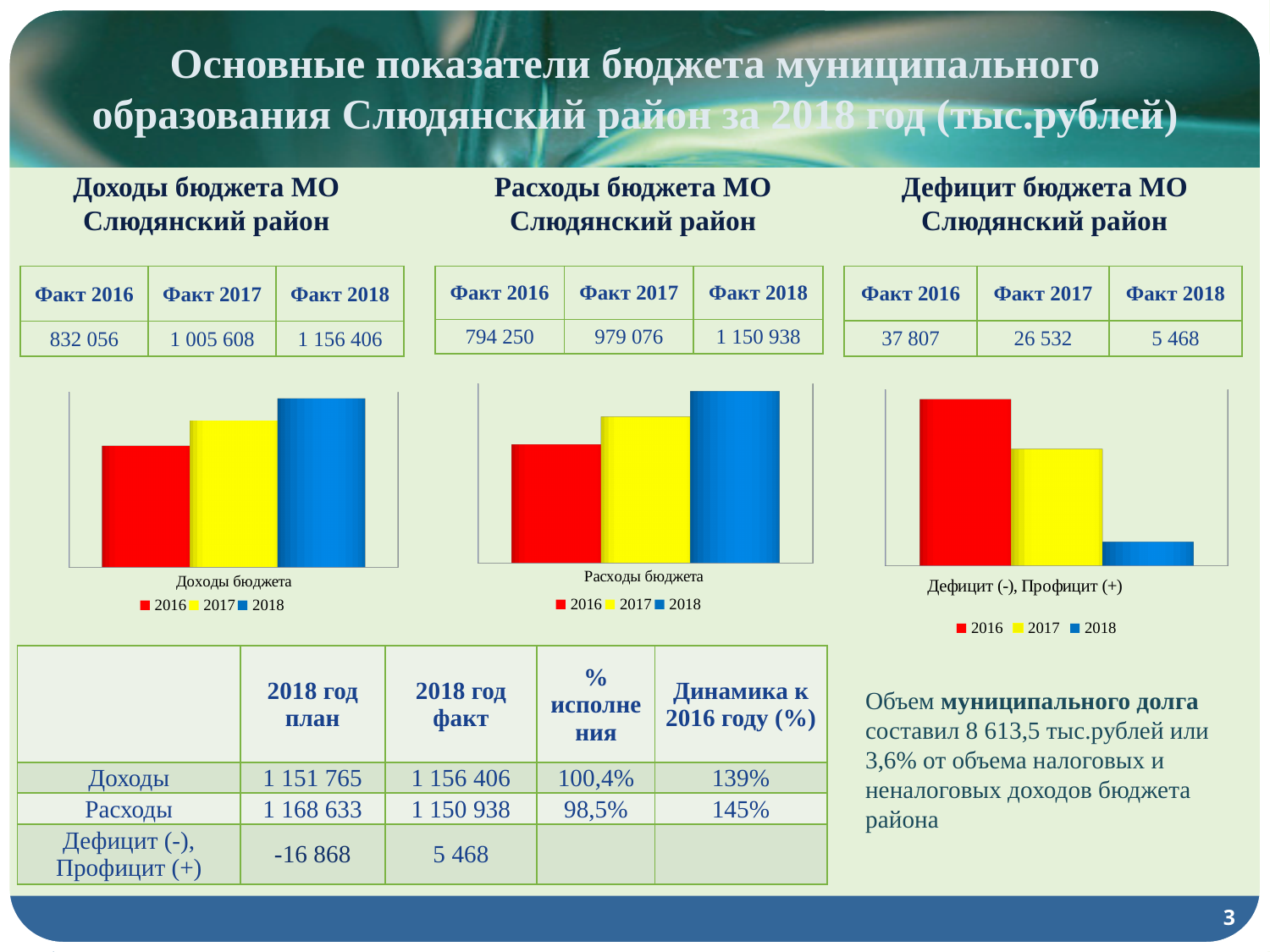
On the left chart (Доходы бюджета МО Слюдянский район), do the bars rise or fall from 2016 to 2018? rise On the left chart (Доходы бюджета МО Слюдянский район), what is the value for 2017 according to the table above the chart? 1 005 608 On the middle chart (Расходы бюджета МО Слюдянский район), what is the difference between the 2018 and 2016 values shown in the table above the chart? 356 688 On the left chart (Доходы бюджета МО Слюдянский район), what kind of chart is shown? bar chart On the right chart (Дефицит бюджета МО Слюдянский район), do the bars rise or fall from 2016 to 2018? fall On the right chart (Дефицит бюджета МО Слюдянский район), which year has the lowest bar? 2018 On the left chart (Доходы бюджета МО Слюдянский район), which year has the highest bar? 2018 On the right chart (Дефицит бюджета МО Слюдянский район), what colour is the bar for 2017? yellow On the middle chart (Расходы бюджета МО Слюдянский район), what is the value for 2018 according to the table above the chart? 1 150 938 On the right chart (Дефицит бюджета МО Слюдянский район), is the bar for 2016 taller or shorter than the bar for 2017? taller On the middle chart (Расходы бюджета МО Слюдянский район), which year has the lowest bar? 2016 On the left chart (Доходы бюджета МО Слюдянский район), how many series does the legend list? 3